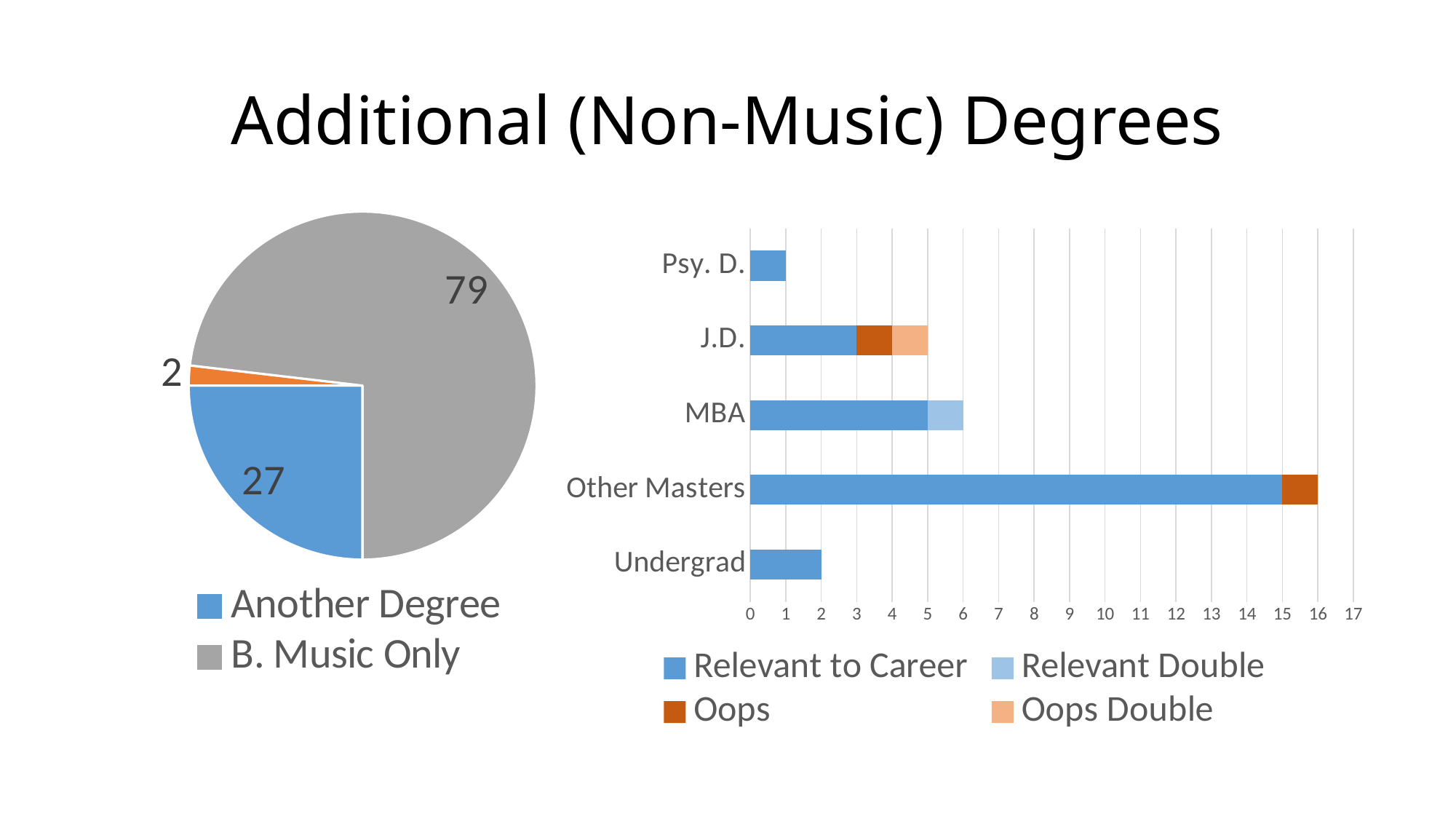
In the bar chart on the right, which category has the shortest total bar? Psy. D. In the bar chart on the right, what is the Relevant to Career value for Undergrad? 2 In the bar chart on the right, is the total value for Other Masters greater or less than 10? greater In the bar chart on the right, which category has the longest total bar? Other Masters In the pie chart on the left, what value is shown for the Another Degree slice? 27 What kind of chart is shown on the right of the slide? Stacked bar chart How many series does the legend of the bar chart on the right list? 4 In the pie chart on the left, what is the difference between the B. Music Only value and the Another Degree value? 52 In the bar chart on the right, what is the total length of the Other Masters bar? 16 How many categories are shown on the bar chart on the right? 5 In the pie chart on the left, which legend category has the largest slice? B. Music Only In the pie chart on the left, what value is shown for the B. Music Only slice? 79